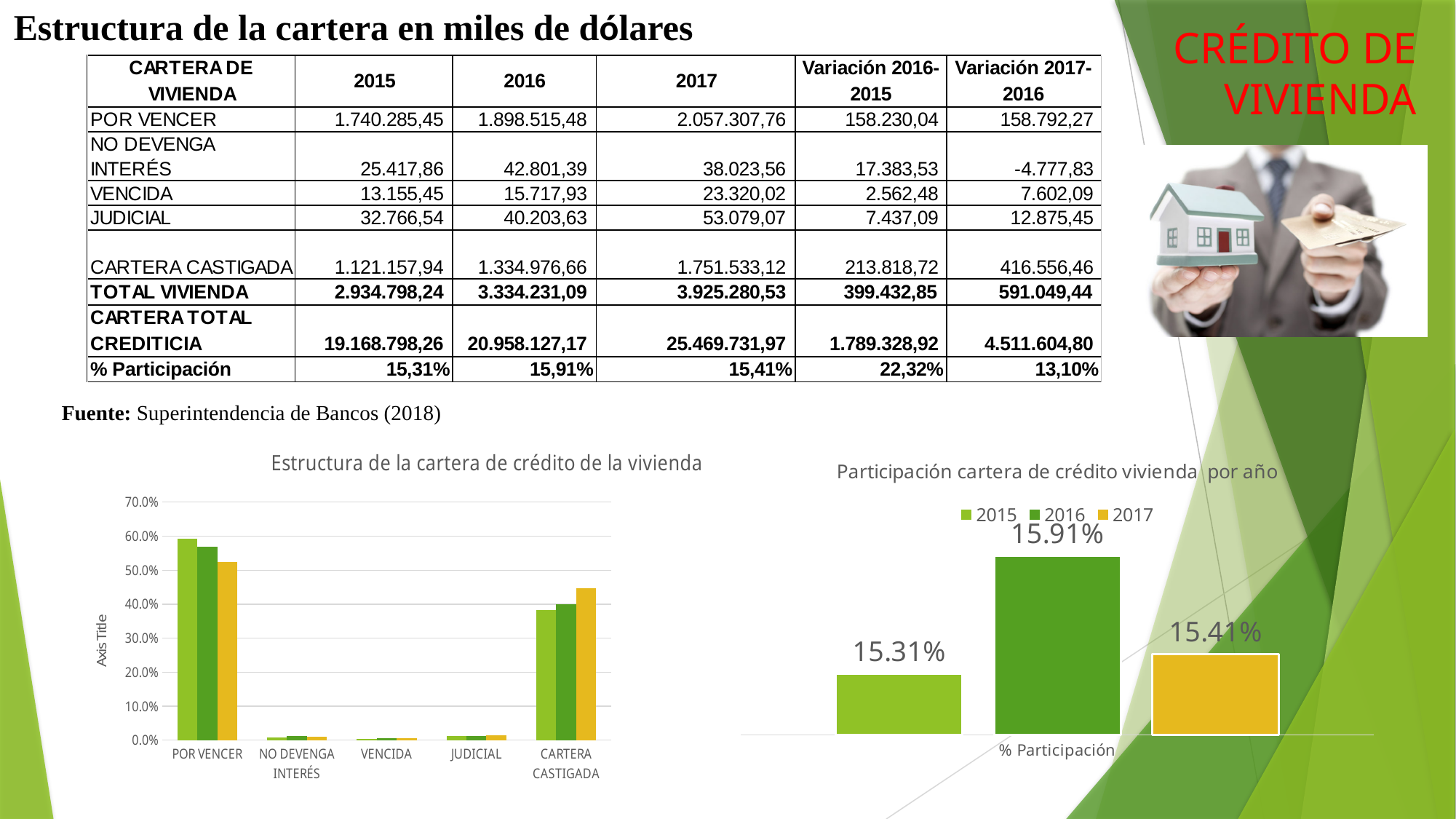
In the chart titled "Participación cartera de crédito vivienda por año", which year has the highest value? 2016 In the chart titled "Participación cartera de crédito vivienda por año", what is the value for 2017? 15.41% In the chart titled "Estructura de la cartera de crédito de la vivienda", are the values for POR VENCER greater or less than 40%? greater In the chart titled "Participación cartera de crédito vivienda por año", what is the difference between the 2016 and 2015 values? 0.60% In the chart titled "Participación cartera de crédito vivienda por año", what is the value for 2016? 15.91% In the chart titled "Participación cartera de crédito vivienda por año", how many series does the legend list? 3 In the chart titled "Estructura de la cartera de crédito de la vivienda", are the values for VENCIDA greater or less than 10%? less In the chart titled "Participación cartera de crédito vivienda por año", what is the value for 2015? 15.31% In the chart titled "Estructura de la cartera de crédito de la vivienda", which category has the tallest bars, POR VENCER or JUDICIAL? POR VENCER In the chart titled "Participación cartera de crédito vivienda por año", which year has the lowest value? 2015 What kind of chart is the one titled "Estructura de la cartera de crédito de la vivienda"? Bar chart In the chart titled "Estructura de la cartera de crédito de la vivienda", how many categories are shown on the x axis? 5